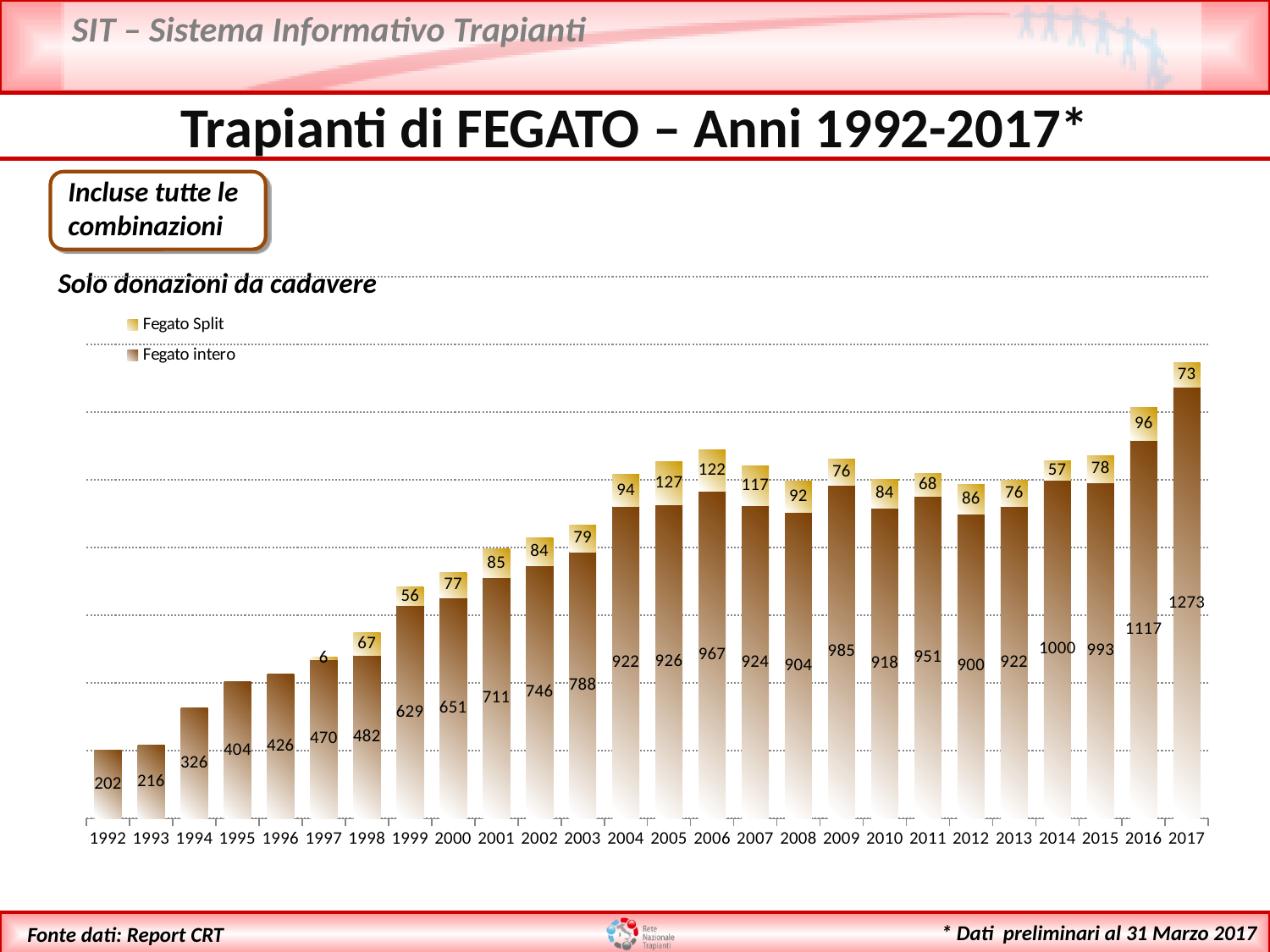
How many series does the legend list? 2 How many years are shown on the x axis? 26 What is the Fegato intero value for 2017? 1273 What is the Fegato Split value for 2005? 127 Which year has the lowest Fegato intero value? 1992 What kind of chart is shown on the slide? Stacked bar chart Which year has the highest Fegato intero value? 2017 Which is larger, the Fegato intero value for 2009 or for 2010? 2009 What is the difference between the Fegato intero values for 2017 and 2016? 156 What is the total of the stacked bar for 2016? 1213 Which year has the highest Fegato Split value? 2005 What is the Fegato intero value for 1992? 202